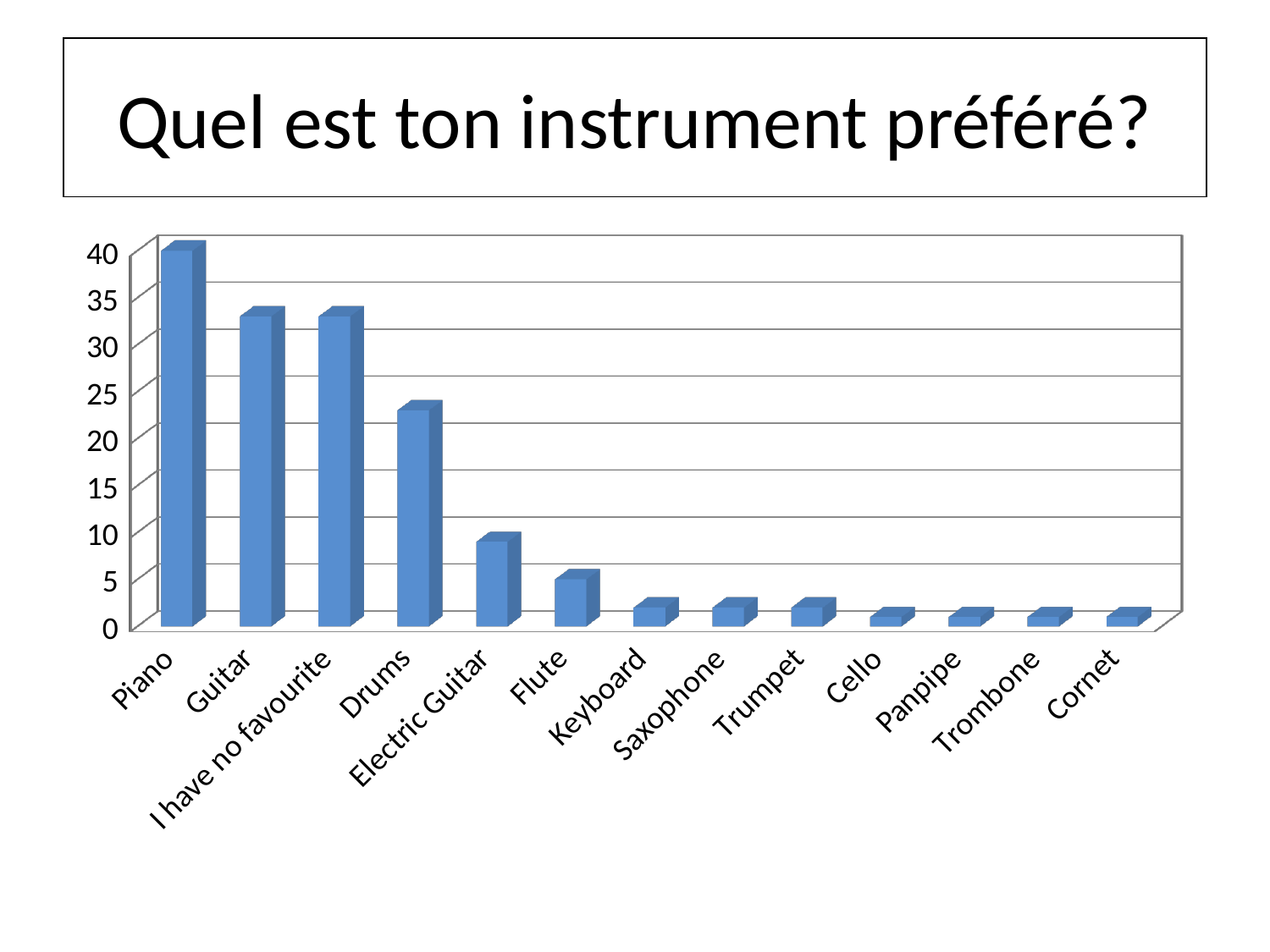
Is the value for Drums greater or less than 20? greater Is the value for Electric Guitar greater or less than 10? less What is the title of the slide? Quel est ton instrument préféré? How many categories are shown on the x axis? 13 Which is larger, the value for Electric Guitar or the value for Guitar? Guitar Is the value for Piano greater or less than 35? greater Which instrument has the highest bar? Piano Do the values generally rise or fall from left to right along the x axis? fall What kind of chart is shown on the slide? bar chart Which is larger, the value for Drums or the value for Flute? Drums